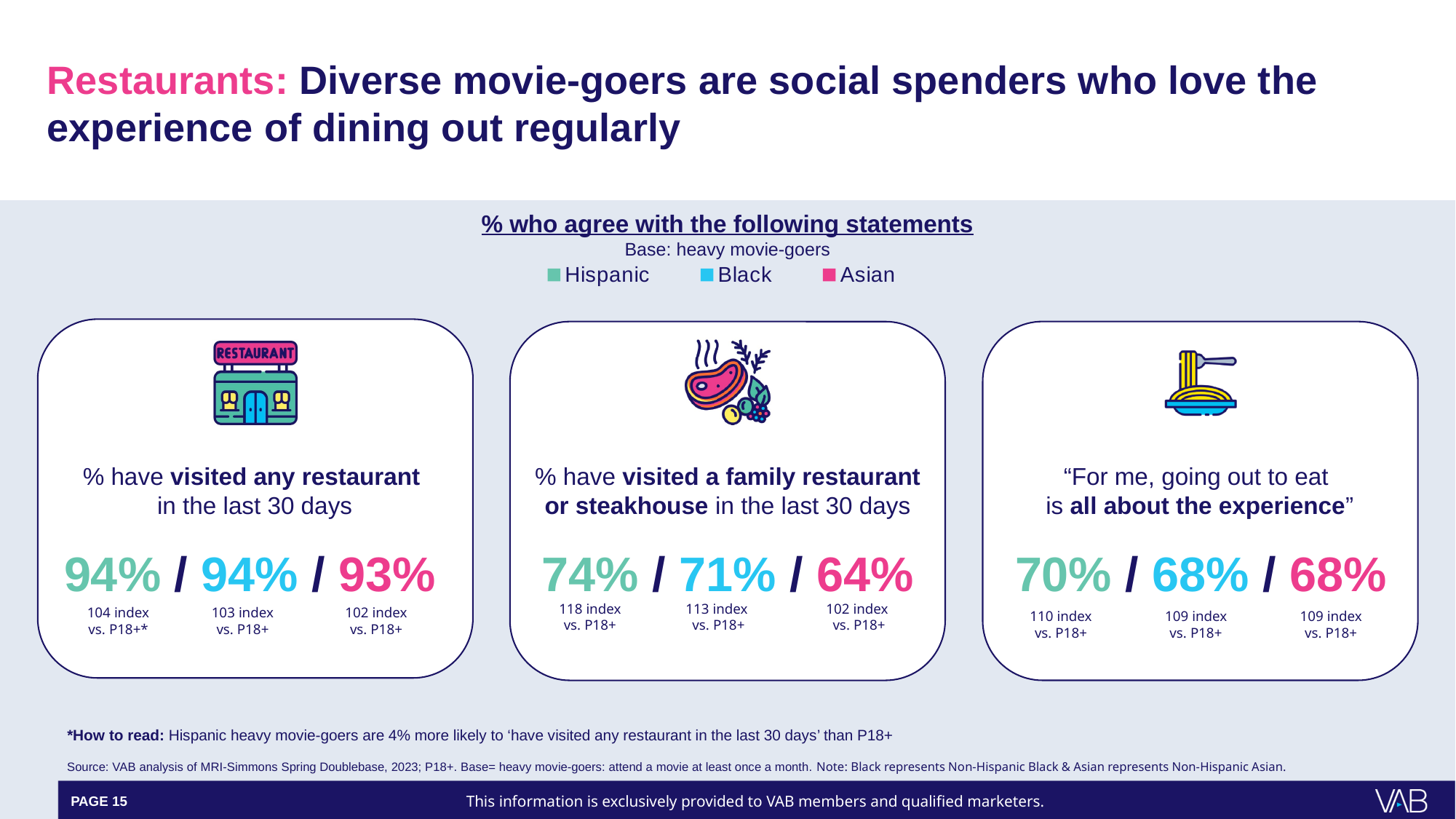
What percentage of Black heavy movie-goers agree that going out to eat is all about the experience? 68% What percentage of Asian heavy movie-goers have visited a family restaurant or steakhouse in the last 30 days? 64% What is the difference between the Hispanic and Asian percentages for visiting a family restaurant or steakhouse in the last 30 days? 10% What colour represents Black in the legend? Blue How many groups does the legend list? 3 For the statement 'going out to eat is all about the experience', is the Hispanic value larger or the Asian value larger? Hispanic Which group has the lowest share who have visited any restaurant in the last 30 days? Asian What is the index vs. P18+ for Hispanic heavy movie-goers who have visited a family restaurant or steakhouse in the last 30 days? 118 index What percentage of Hispanic heavy movie-goers have visited any restaurant in the last 30 days? 94% How many statements are shown on the slide? 3 What is the index vs. P18+ for Asian heavy movie-goers who agree that going out to eat is all about the experience? 109 index Which group has the highest share who have visited a family restaurant or steakhouse in the last 30 days? Hispanic